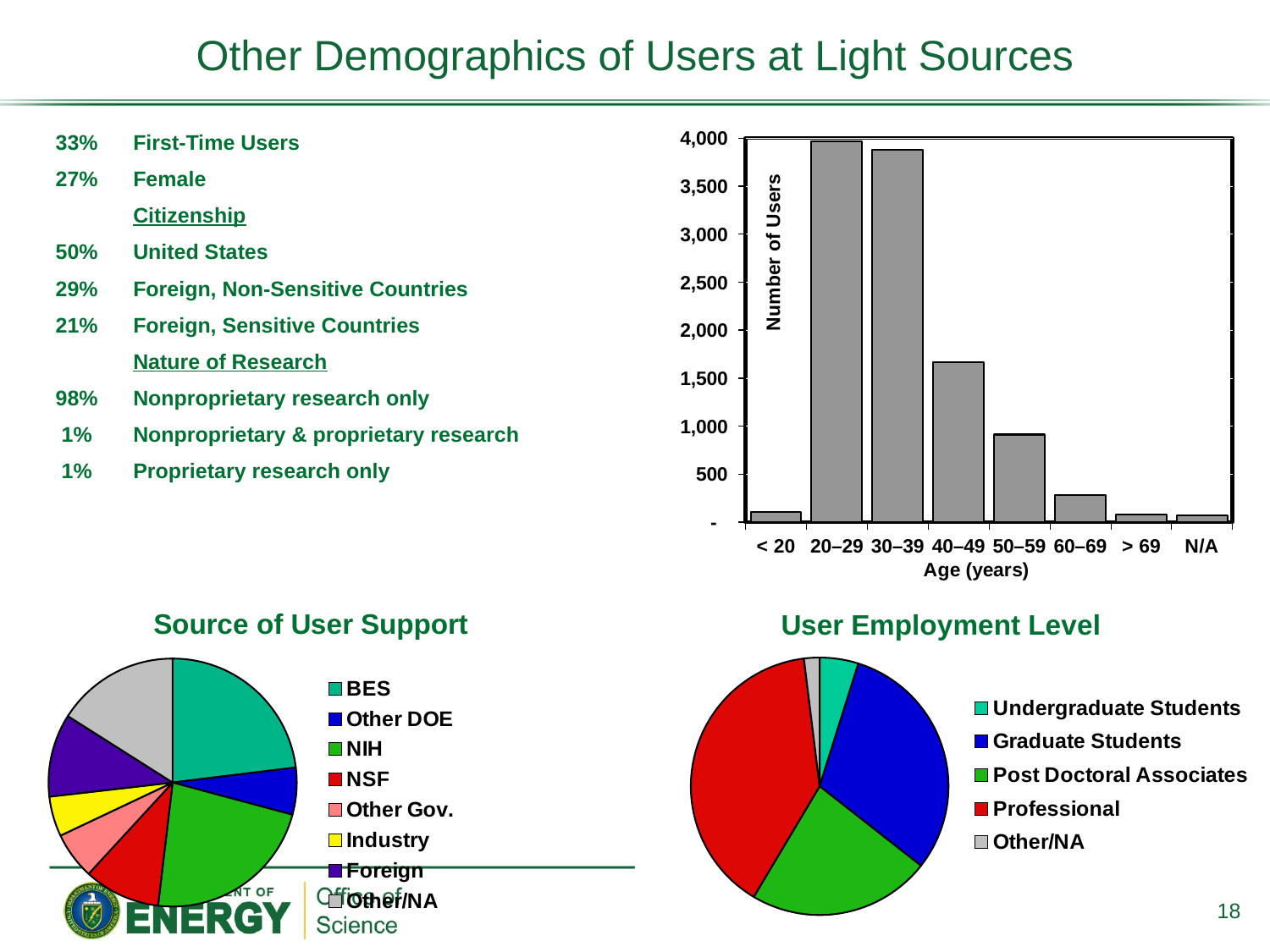
In the 'User Employment Level' pie chart, which category has the largest slice? Professional In the bar chart of Number of Users by Age (years), how many age categories are shown on the x axis? 8 In the bar chart of Number of Users by Age (years), is the value for 40–49 greater or less than 1,500? greater In the bar chart of Number of Users by Age (years), which is larger, the value for 40–49 or the value for 50–59? 40–49 In the bar chart of Number of Users by Age (years), do the values rise or fall from 20–29 through > 69? fall In the bar chart of Number of Users by Age (years), is the value for 60–69 greater or less than 500? less What kind of chart is the 'Source of User Support' chart? pie chart In the bar chart of Number of Users by Age (years), is the value for 50–59 greater or less than 1,000? less In the 'Source of User Support' pie chart, which slice is larger, BES or Industry? BES In the 'User Employment Level' pie chart, which slice is larger, Graduate Students or Post Doctoral Associates? Graduate Students How many entries does the legend of the 'Source of User Support' chart list? 8 What kind of chart is the chart at the top right showing Number of Users by Age (years)? bar chart